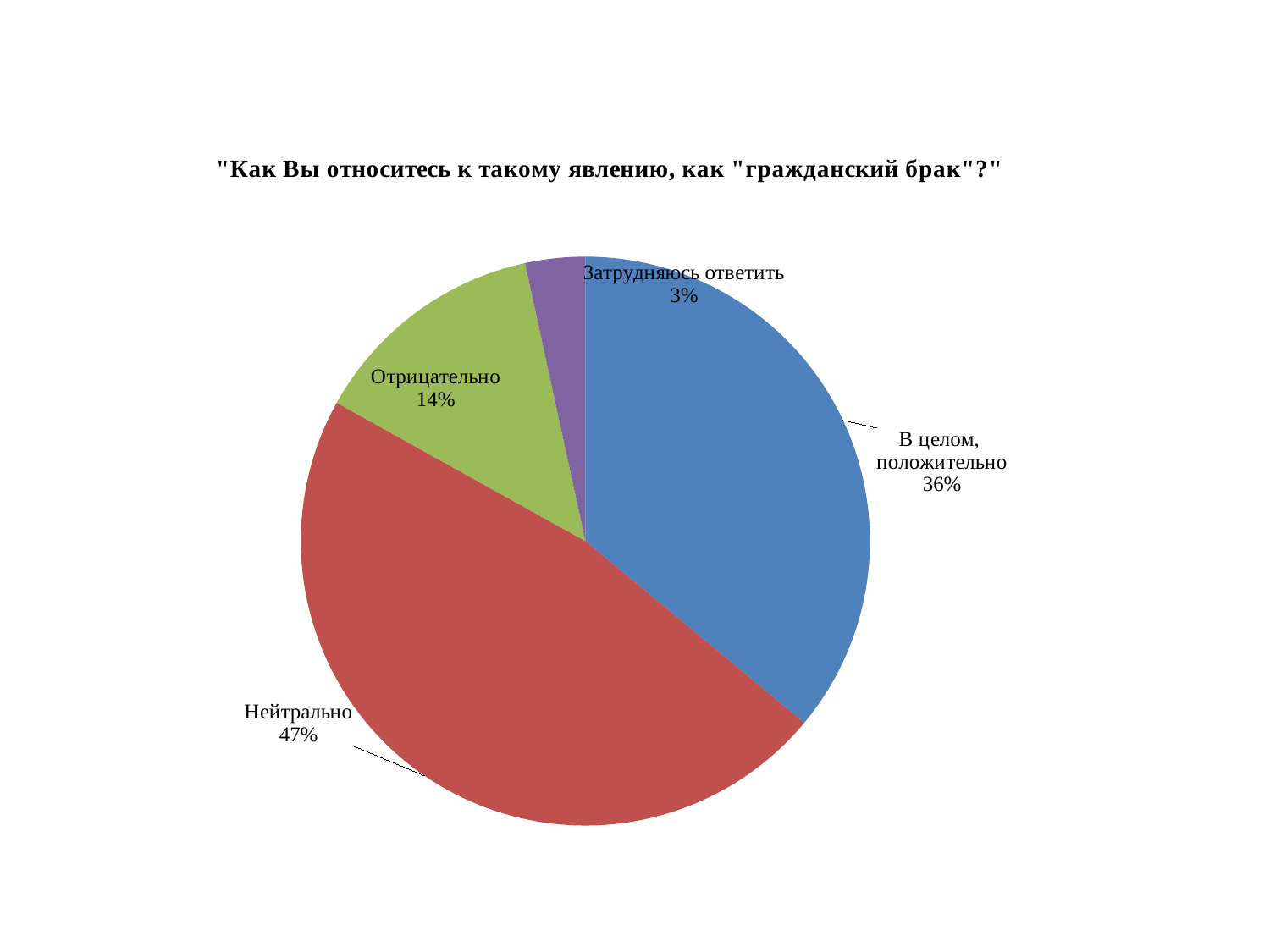
Which response has the largest share of the pie? Нейтрально Which response has the smallest share of the pie? Затрудняюсь ответить What is the difference in percentage points between "Нейтрально" and "В целом, положительно"? 11 What colour is the slice for "Нейтрально"? red What share of respondents answered "В целом, положительно"? 36% What share of respondents answered "Нейтрально"? 47% What share of respondents answered "Отрицательно"? 14% Which is larger: the share for "Отрицательно" or the share for "Затрудняюсь ответить"? Отрицательно What is the title of the chart? "Как Вы относитесь к такому явлению, как "гражданский брак"?" What kind of chart is shown on the slide? pie chart How many slices does the pie chart have? 4